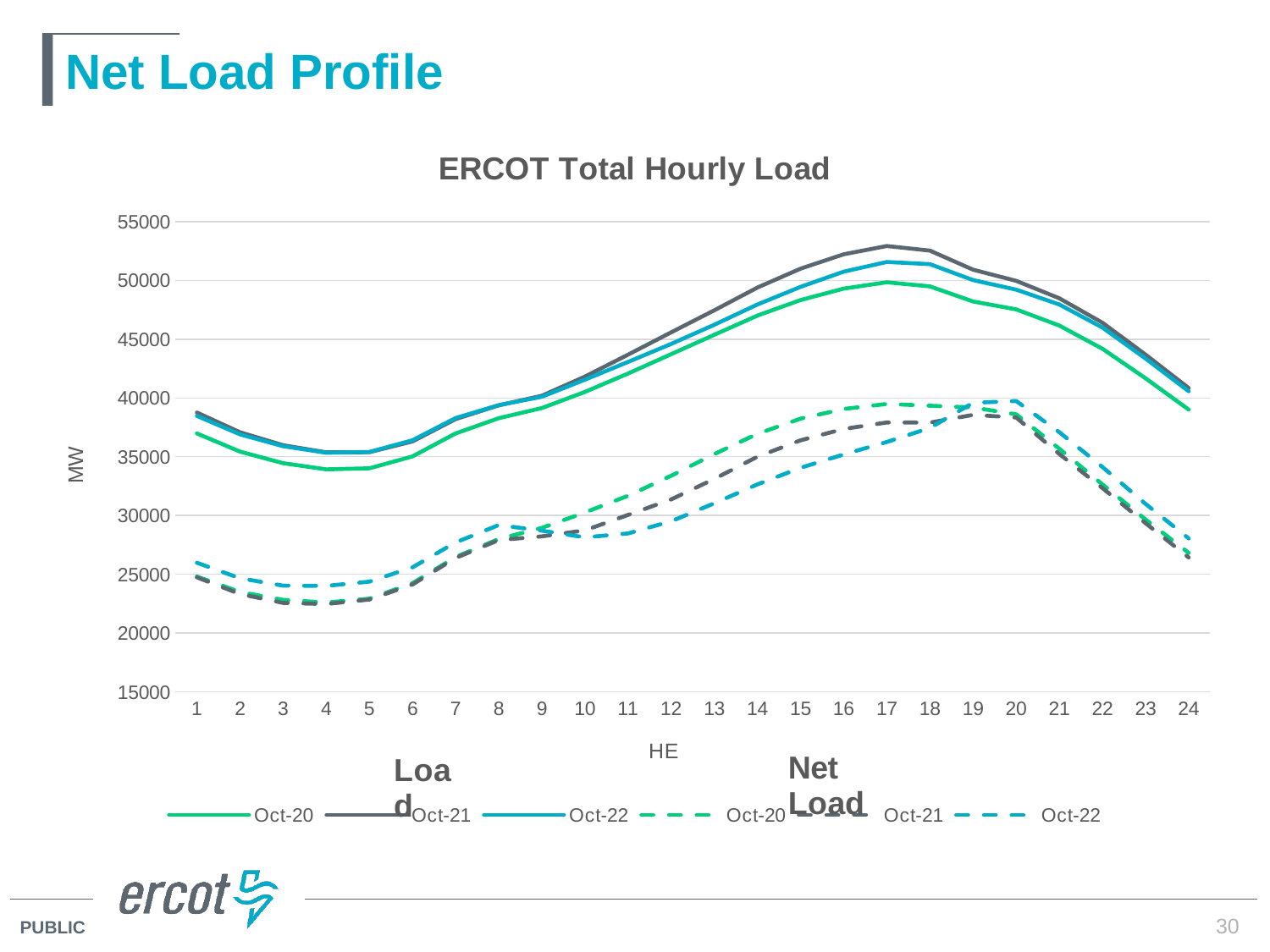
Is the Net Load Oct-22 value at hour 1 greater or less than 25000? greater How many series does the legend list? 6 Is the Net Load Oct-20 value at hour 4 greater or less than 25000? less At hour 17, which is higher: Load Oct-21 or Load Oct-20? Load Oct-21 What is the title of the chart? ERCOT Total Hourly Load At hour 12, which is higher: Net Load Oct-20 or Net Load Oct-22? Net Load Oct-20 How many hours (HE) are plotted along the x axis? 24 Is the Load Oct-21 value at hour 24 greater or less than 45000? less Does the Load Oct-22 series rise or fall from hour 17 to hour 24? fall What unit is shown on the y-axis label of the chart? MW What kind of chart is shown on the slide? line chart